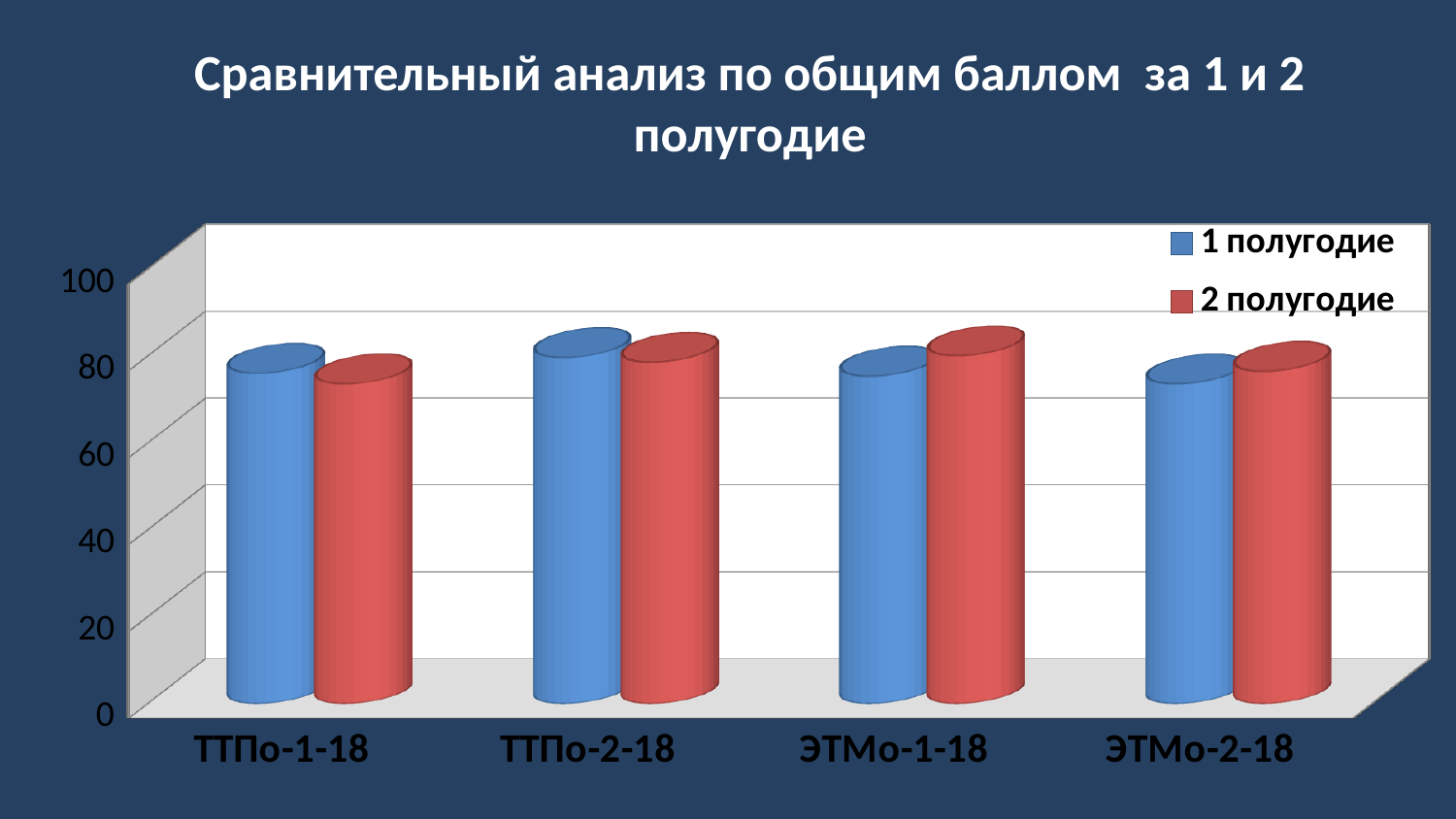
How many series does the legend list? 2 Is the "1 полугодие" value for ТТПо-2-18 greater or less than 100? less How many categories (groups) are shown along the x axis? 4 What kind of chart is shown on the slide? bar chart Which category has the highest value for "1 полугодие"? ТТПо-2-18 Which category has the lowest value for "2 полугодие"? ТТПо-1-18 Which is larger: the "1 полугодие" value for ТТПо-2-18 or the "1 полугодие" value for ЭТМо-2-18? ТТПо-2-18 Which category has the highest value for "2 полугодие"? ЭТМо-1-18 What is the title of the chart? Сравнительный анализ по общим баллом за 1 и 2 полугодие Which colour represents the series "2 полугодие"? red Is the "2 полугодие" value for ТТПо-1-18 greater or less than 60? greater For ЭТМо-1-18, which is larger: "1 полугодие" or "2 полугодие"? 2 полугодие